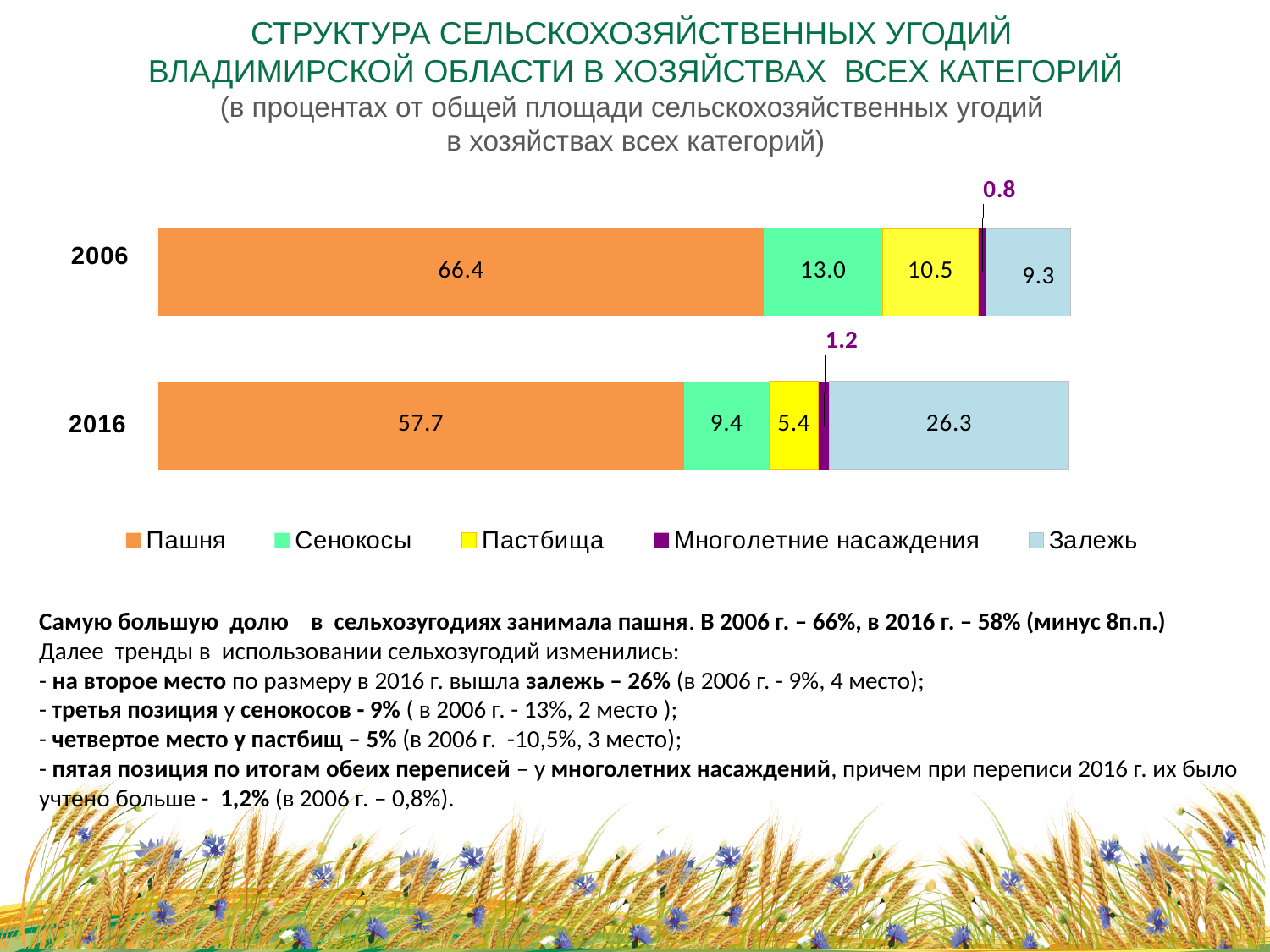
What is the value for Залежь in 2016? 26.3 What is the difference between the Пашня values for 2006 and 2016? 8.7 What is the total of the 2016 stacked bar? 100.0 How many series does the legend list? 5 Which series has the largest value in the 2016 bar? Пашня What kind of chart is shown on the slide? Stacked bar chart What is the value for Пастбища in 2006? 10.5 Which is larger: Сенокосы in 2006 or Залежь in 2006? Сенокосы in 2006 Which series has the smallest value in the 2006 bar? Многолетние насаждения What is the value for Многолетние насаждения in 2016? 1.2 How many years (categories) are plotted on the chart? 2 What is the value for Пашня in 2006? 66.4